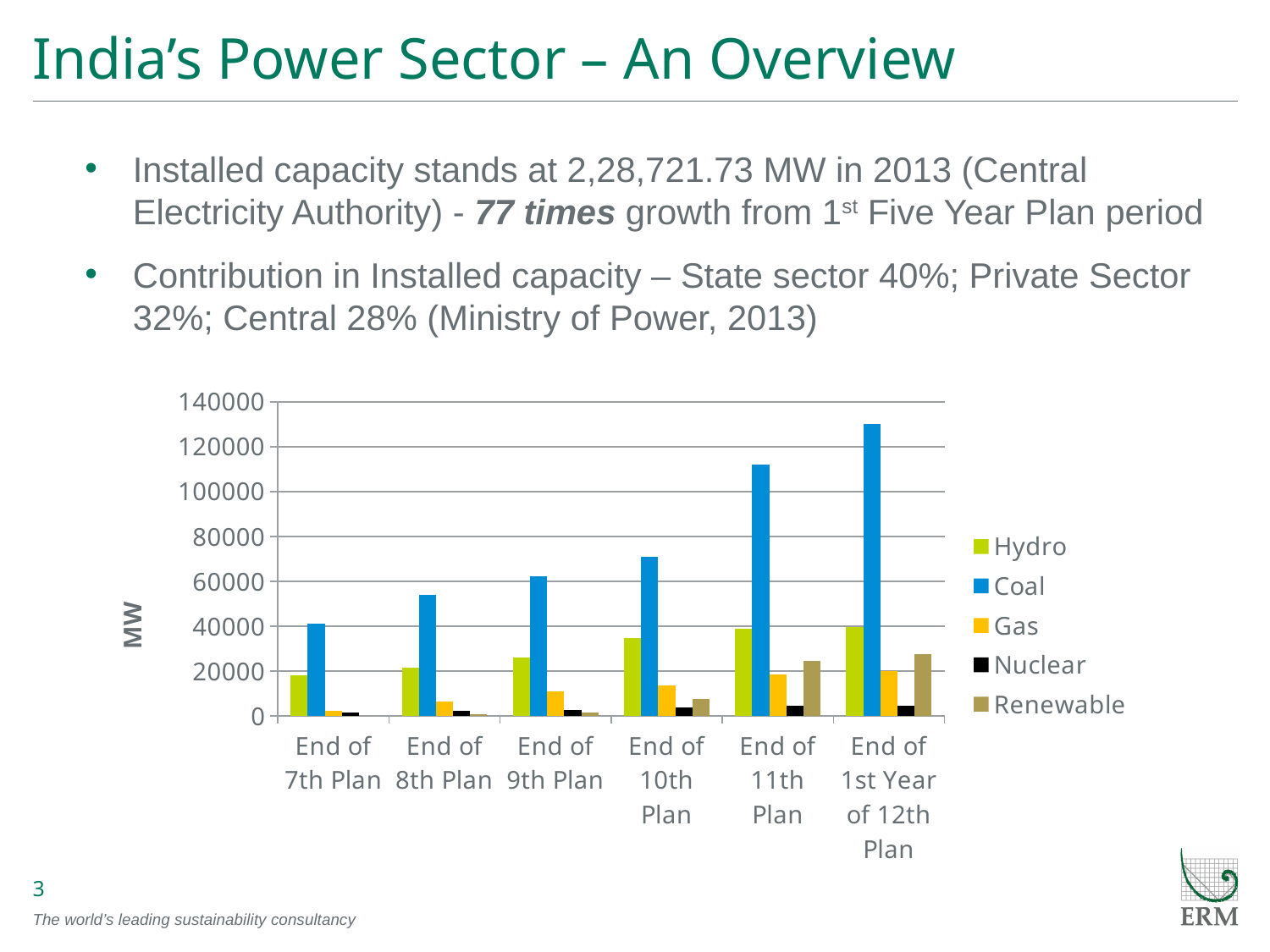
Which series has the highest value at End of 1st Year of 12th Plan? Coal Is the value for Coal at End of 7th Plan greater or less than 60000? less Is the value for Coal at End of 1st Year of 12th Plan greater or less than 120000? greater How many series does the chart's legend list? 5 Which series has the lowest value at End of 11th Plan? Nuclear What kind of chart is shown on the slide? bar chart At End of 10th Plan, which is larger: Hydro or Gas? Hydro What is the label on the chart's vertical axis? MW Do the Coal values rise or fall from End of 7th Plan to End of 1st Year of 12th Plan? rise Is the value for Coal at End of 11th Plan greater or less than 100000? greater At End of 11th Plan, which is larger: Renewable or Gas? Renewable How many plan periods (categories) are shown on the x axis of the chart? 6